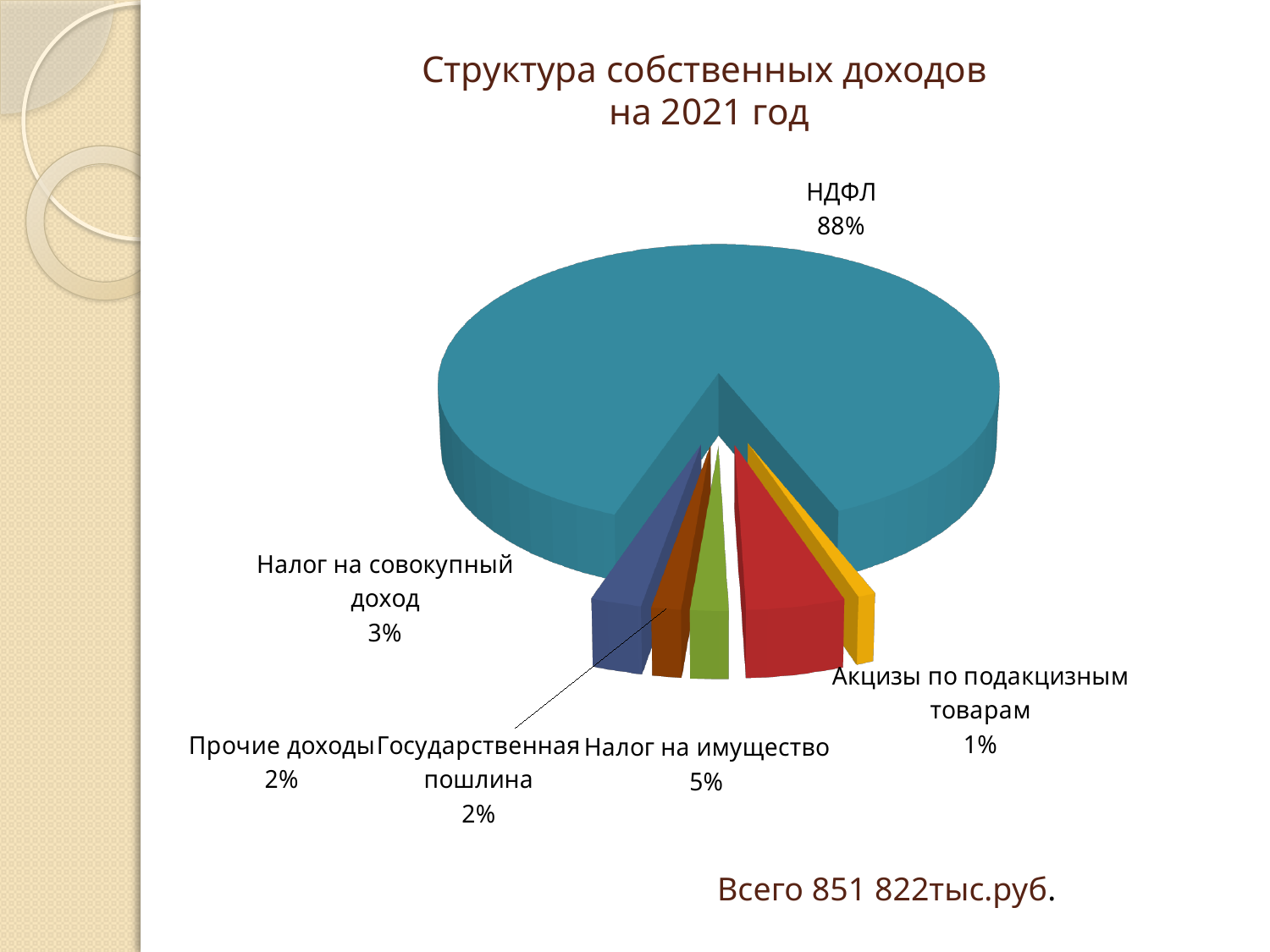
What type of chart is shown on the slide? Pie chart What share of the pie does НДФЛ account for? 88% What percentage is shown for Налог на имущество? 5% Which is larger, Налог на имущество or Налог на совокупный доход? Налог на имущество Which category has the largest slice of the pie? НДФЛ Which category has the smallest slice of the pie? Акцизы по подакцизным товарам What total amount is stated below the chart? 851 822 тыс.руб. What percentage is shown for Акцизы по подакцизным товарам? 1% How many slices does the pie chart have? 6 What is the title of the chart? Структура собственных доходов на 2021 год What is the difference in percentage points between НДФЛ and Налог на имущество? 83 What percentage is shown for Налог на совокупный доход? 3%